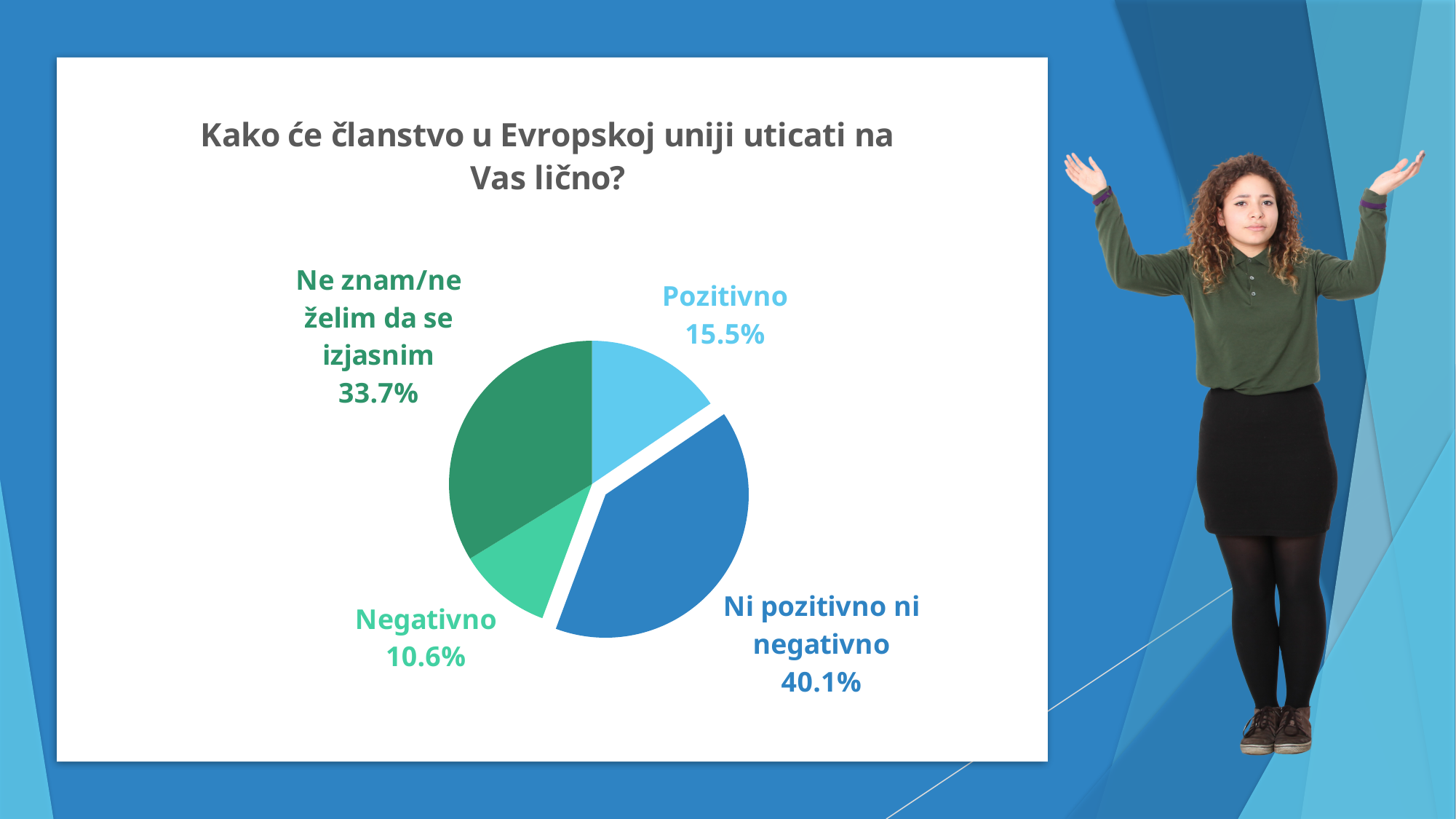
What is the value for Ne znam/ne želim da se izjasnim? 33.7% Which category has the largest share of the pie? Ni pozitivno ni negativno What kind of chart is shown on the slide? pie chart What is the value for Negativno? 10.6% What is the difference between the values for Ni pozitivno ni negativno and Ne znam/ne želim da se izjasnim? 6.4% Which slice is separated (exploded) from the rest of the pie? Ni pozitivno ni negativno What is the title of the chart? Kako će članstvo u Evropskoj uniji uticati na Vas lično? What is the value for Pozitivno? 15.5% What is the value for Ni pozitivno ni negativno? 40.1% Which category has the smallest share of the pie? Negativno Which is larger, the value for Pozitivno or the value for Negativno? Pozitivno How many categories does the pie chart have? 4